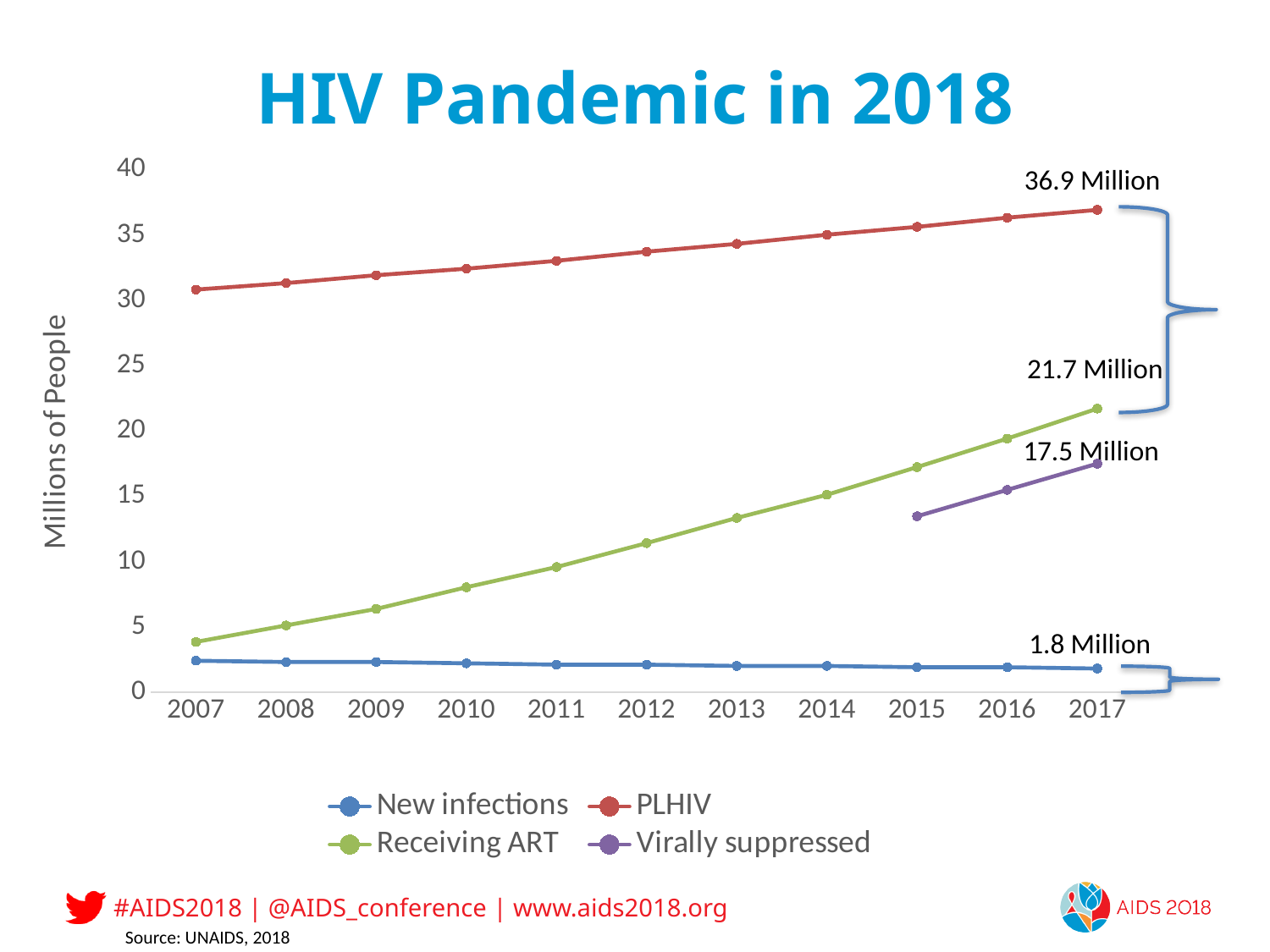
What is the difference between PLHIV and Receiving ART in 2017? 15.2 Million Which series has the highest value in 2017? PLHIV Does the Receiving ART series rise or fall from 2007 to 2017? rise What is the value for New infections in 2017? 1.8 Million Which series has the lowest value in 2017? New infections What is the value for Receiving ART in 2017? 21.7 Million Which is larger in 2017, Receiving ART or Virally suppressed? Receiving ART What is the value for Virally suppressed in 2017? 17.5 Million What is the value for PLHIV in 2017? 36.9 Million Is the value for Receiving ART in 2007 greater or less than 5? less How many years are shown on the x axis? 11 How many series does the legend list? 4